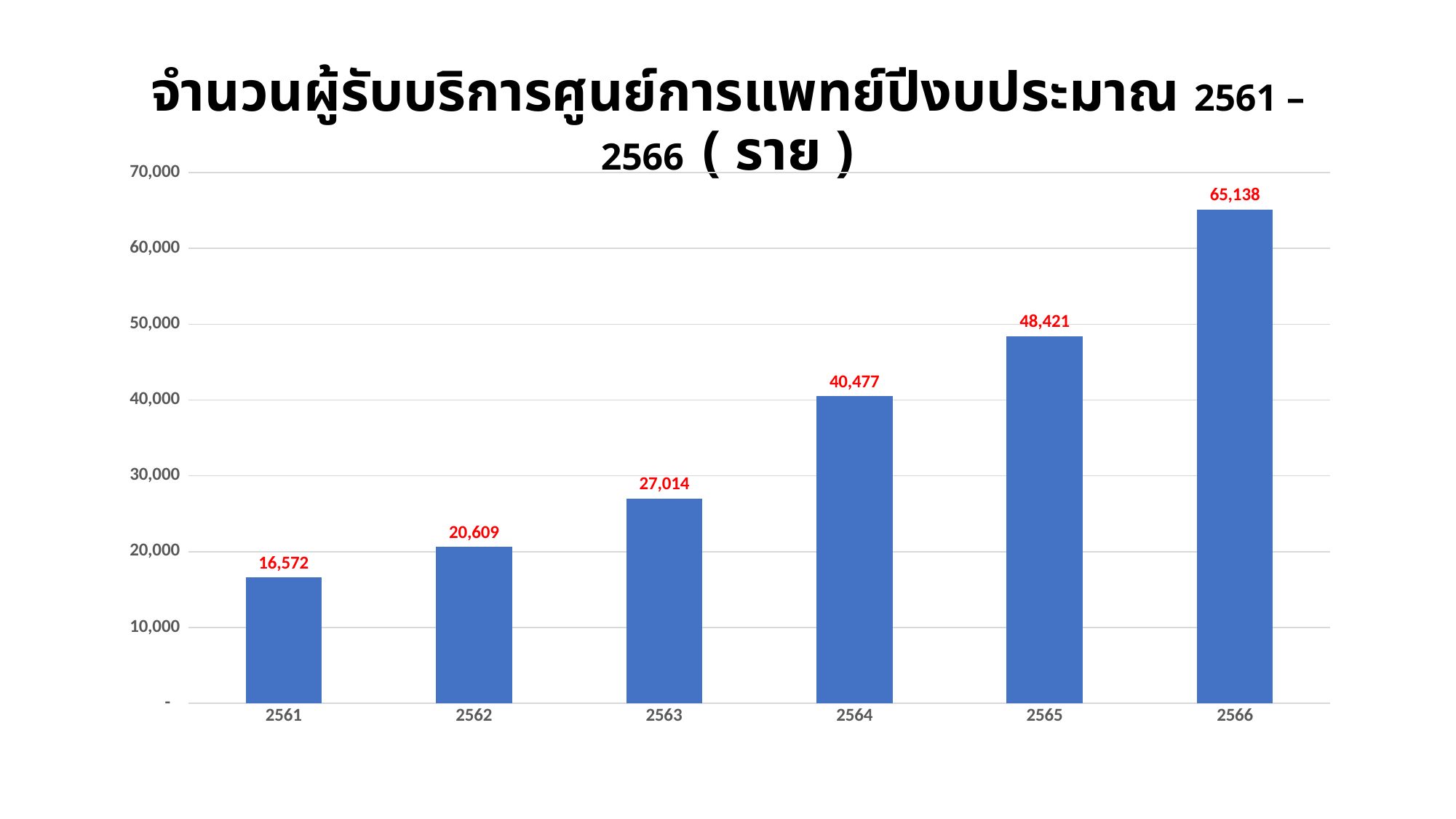
How many years are shown on the x axis? 6 What is the value for 2564? 40,477 Which is larger, the value for 2563 or the value for 2564? 2564 Which year has the lowest value? 2561 What is the difference between the values for 2563 and 2562? 6,405 Which year has the highest value? 2566 What is the value for 2561? 16,572 What is the value for 2566? 65,138 Do the values rise or fall from 2561 to 2566? rise What kind of chart is shown on the slide? bar chart What is the difference between the values for 2566 and 2565? 16,717 Is the value for 2565 greater or less than 50,000? less